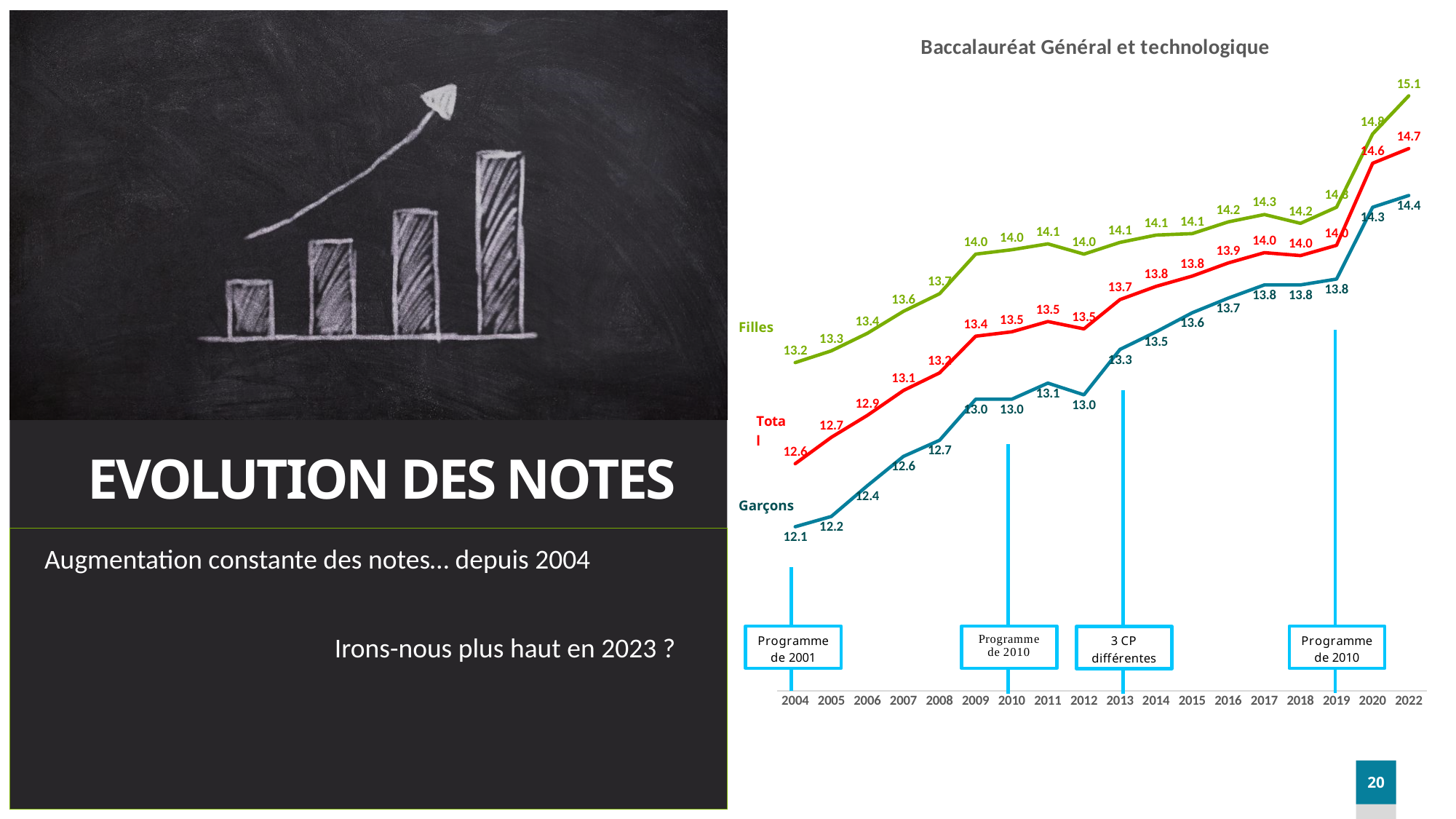
Which year has the lowest value for Garçons? 2004 What is the title of the chart? Baccalauréat Général et technologique What is the value for Filles in 2004? 13.2 What kind of chart is shown? Line chart What is the value for Garçons in 2022? 14.4 Which year has the highest value for Filles? 2022 What is the value for Total in 2013? 13.7 How many years are shown on the x axis? 18 What is the difference between the Filles value and the Garçons value in 2022? 0.7 What is the value for Garçons in 2008? 12.7 Which is larger in 2012: the Total value or the Garçons value? Total How many series are plotted on the chart? 3